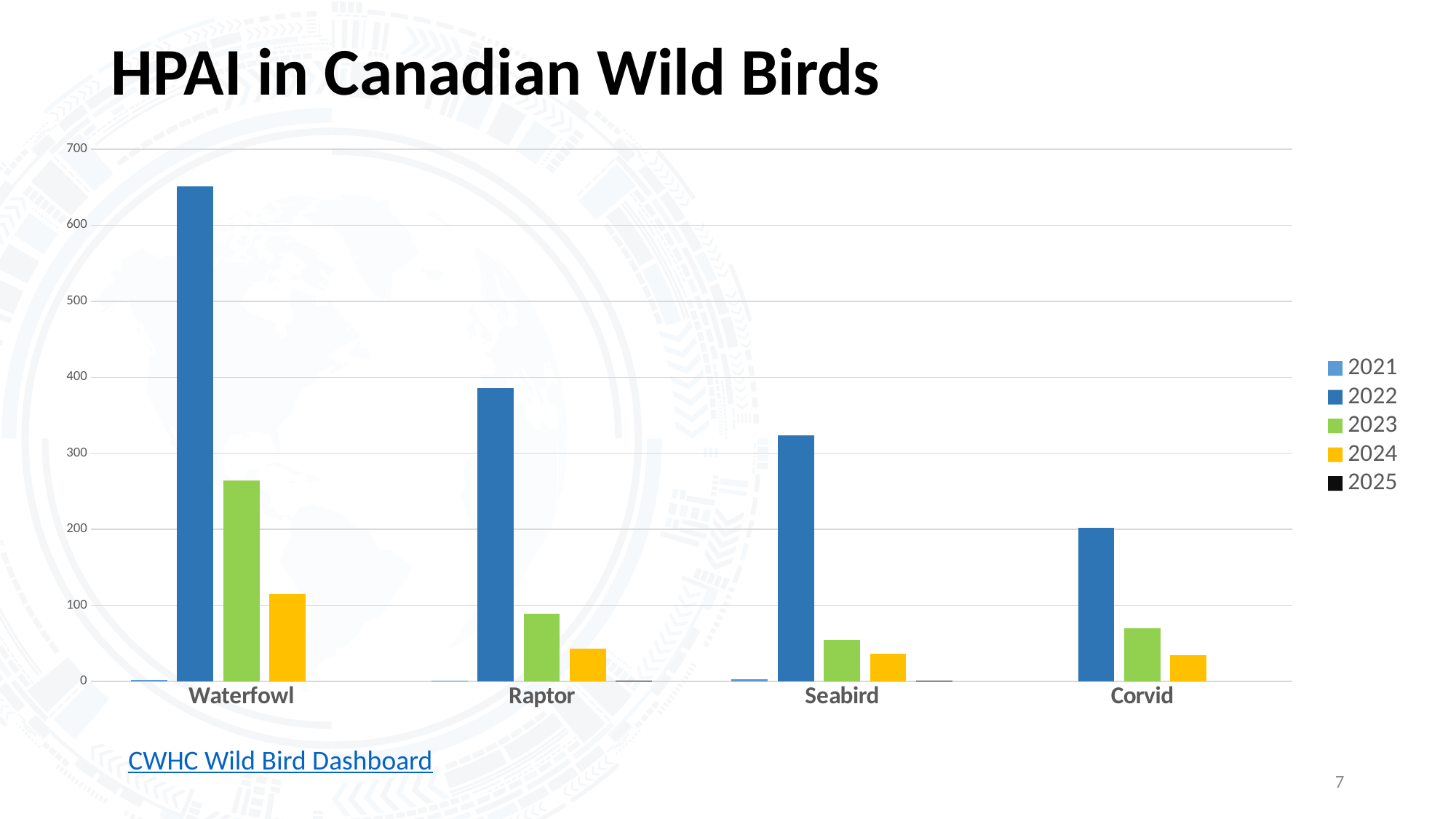
Which bird category has the lowest 2022 value? Corvid Is the 2022 value for Raptor greater or less than 400? less Which is larger for Raptor, the 2023 value or the 2024 value? 2023 Which bird category has the highest 2022 value? Waterfowl Do the 2022 values rise or fall moving from Waterfowl to Corvid along the x axis? fall How many bird categories are shown on the x axis? 4 Which colour represents the 2024 series in the legend? yellow Is the 2022 value for Seabird greater or less than 300? greater Is the 2022 value for Waterfowl greater or less than 600? greater What kind of chart is shown on the slide? bar chart How many series does the legend list? 5